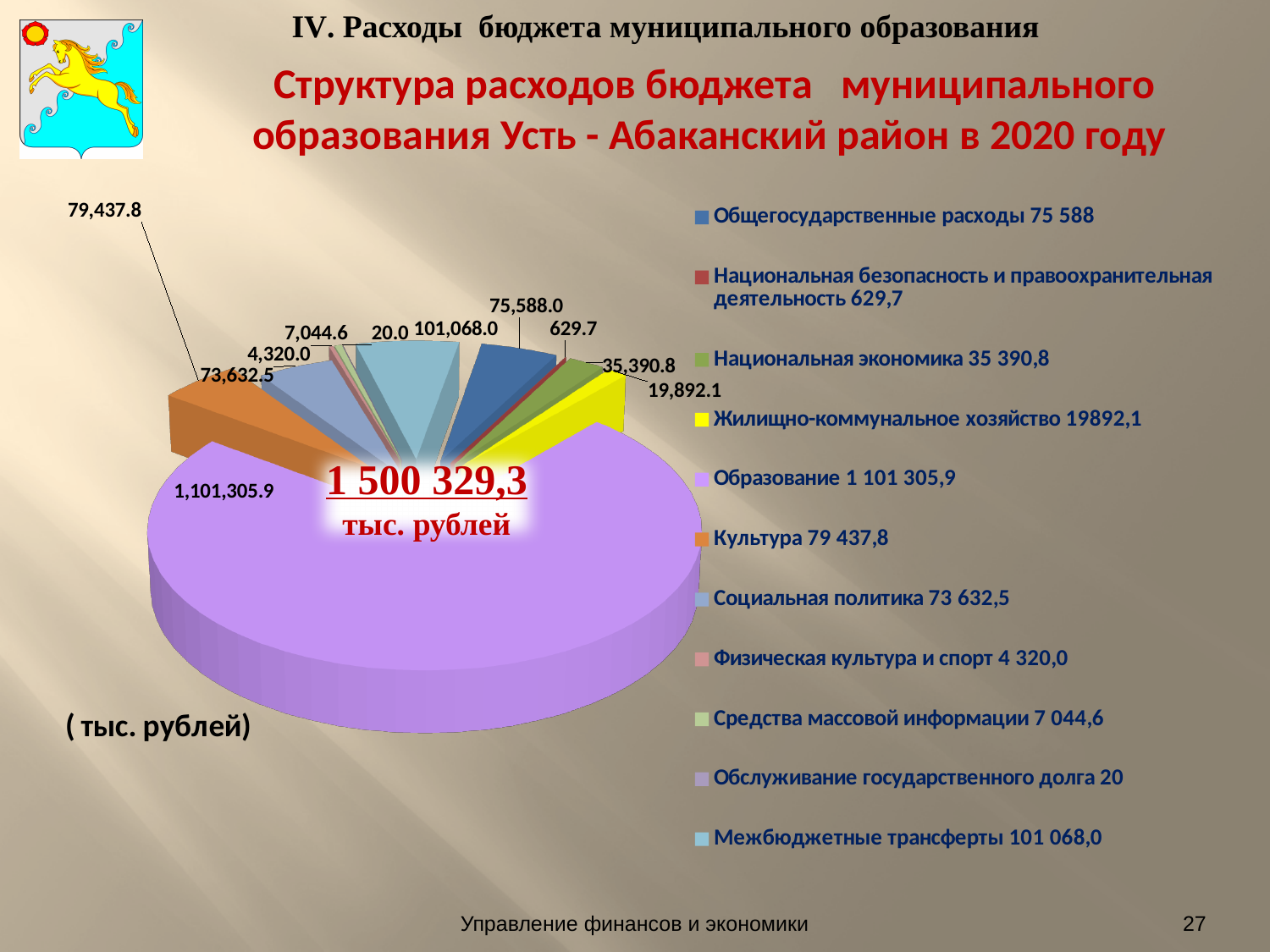
What total amount is printed in the centre of the pie chart? 1 500 329,3 тыс. рублей What colour is the slice for Жилищно-коммунальное хозяйство in the pie chart? yellow What is the difference between the values for Межбюджетные трансферты (101,068.0) and Общегосударственные расходы (75,588.0)? 25,480.0 How many categories does the legend of the pie chart list? 11 What is the value shown for Межбюджетные трансферты in the pie chart? 101,068.0 What is the difference between the values for Культура (79,437.8) and Социальная политика (73,632.5)? 5,805.3 Which is larger in the pie chart: Национальная экономика or Жилищно-коммунальное хозяйство? Национальная экономика What kind of chart is shown on the slide? pie chart Which category has the smallest value in the pie chart? Обслуживание государственного долга Which category has the largest slice of the pie chart? Образование What value does the legend give for Национальная безопасность и правоохранительная деятельность? 629,7 What is the value shown for Культура in the pie chart? 79,437.8